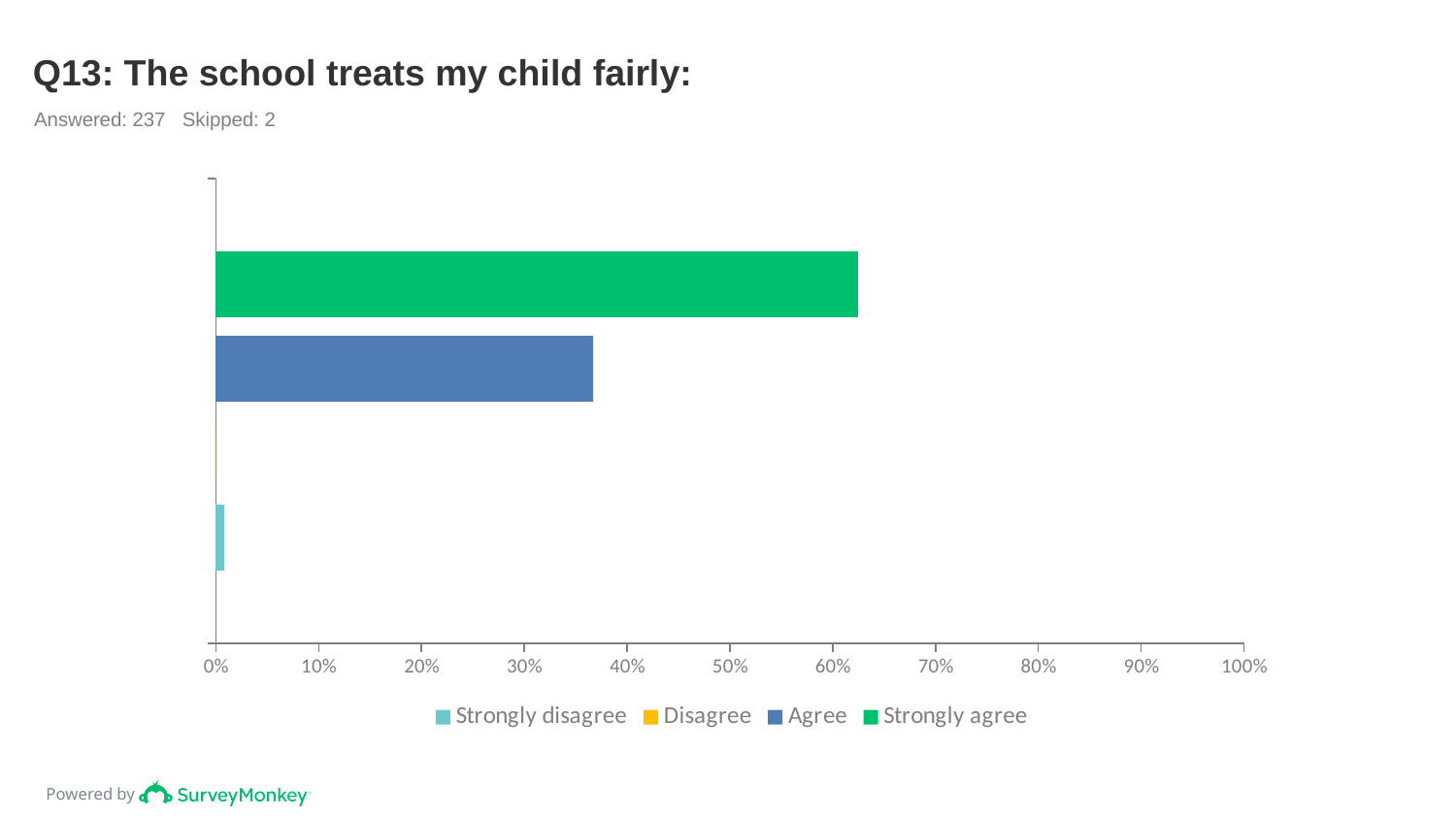
Which is larger, the value for Agree or the value for Strongly agree? Strongly agree What is the title of the chart? Q13: The school treats my child fairly: How many series does the legend list? 4 Which is larger, the value for Strongly disagree or the value for Agree? Agree Is the value for Agree greater or less than 40%? less Is the value for Strongly agree greater or less than 70%? less How many respondents answered this question according to the slide? 237 Is the value for Strongly agree greater or less than 50%? greater Which response option has the highest value? Strongly agree What kind of chart is shown on the slide? bar chart